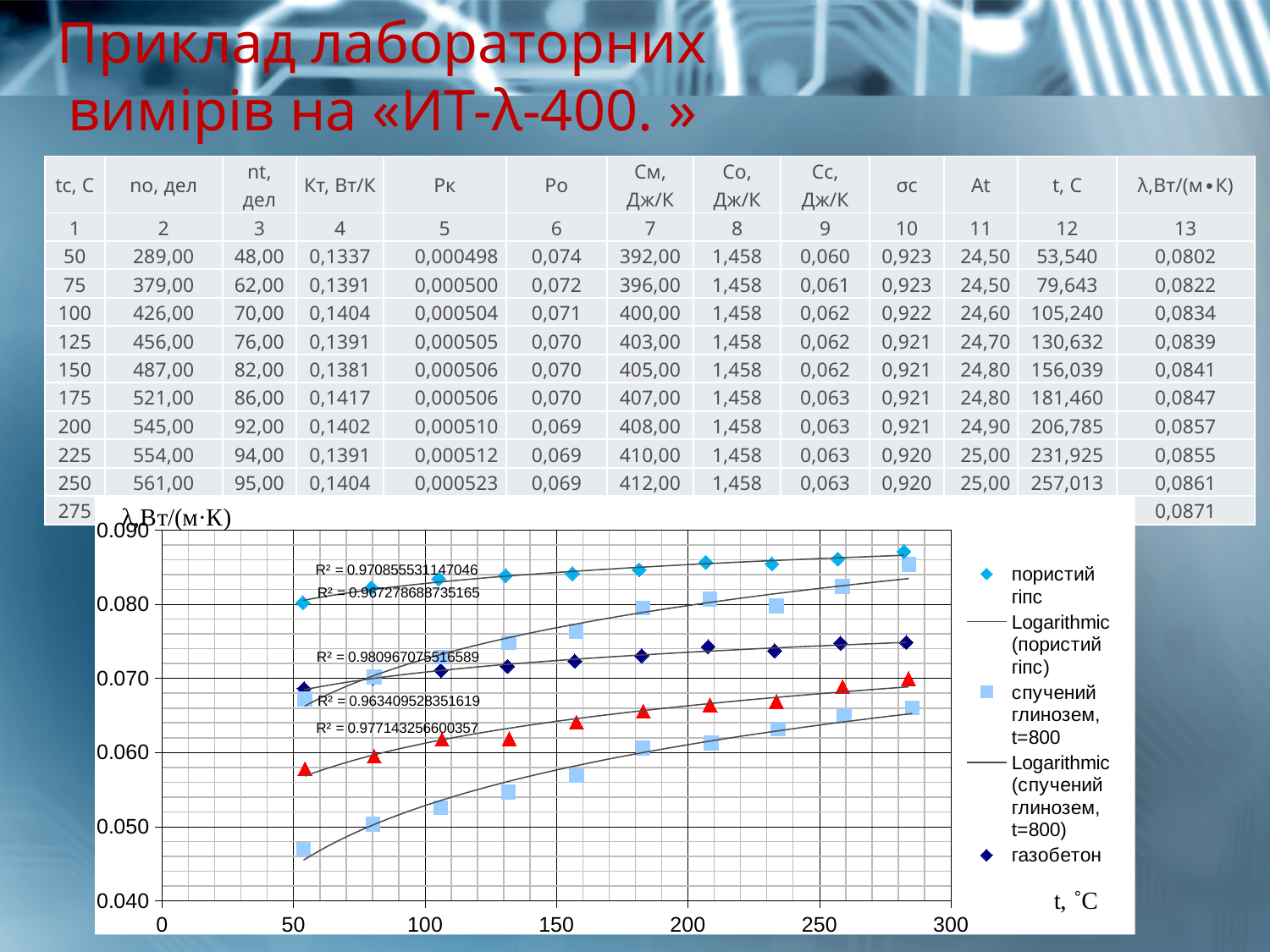
Which series on the chart has the highest λ values across the whole temperature range? пористий гіпс At about 280 °C, which is larger: the value for пористий гіпс or the value for газобетон? пористий гіпс What kind of chart is shown below the table? scatter chart Do the values for пористий гіпс rise or fall as t increases along the x axis? rise What is the label of the chart's x axis? t, °C What is the label of the chart's y axis? λ, Вт/(м·К) What is the smallest R² value printed on the chart? R² = 0.963409528351619 Is the lowest plotted point on the chart (at about 50 °C) greater or less than 0.050? less Is the value for пористий гіпс at about 280 °C greater or less than 0.080? greater How many R² values are printed on the chart? 5 What is the largest R² value printed on the chart? R² = 0.980967075516589 Is the value for газобетон at about 50 °C greater or less than 0.070? less